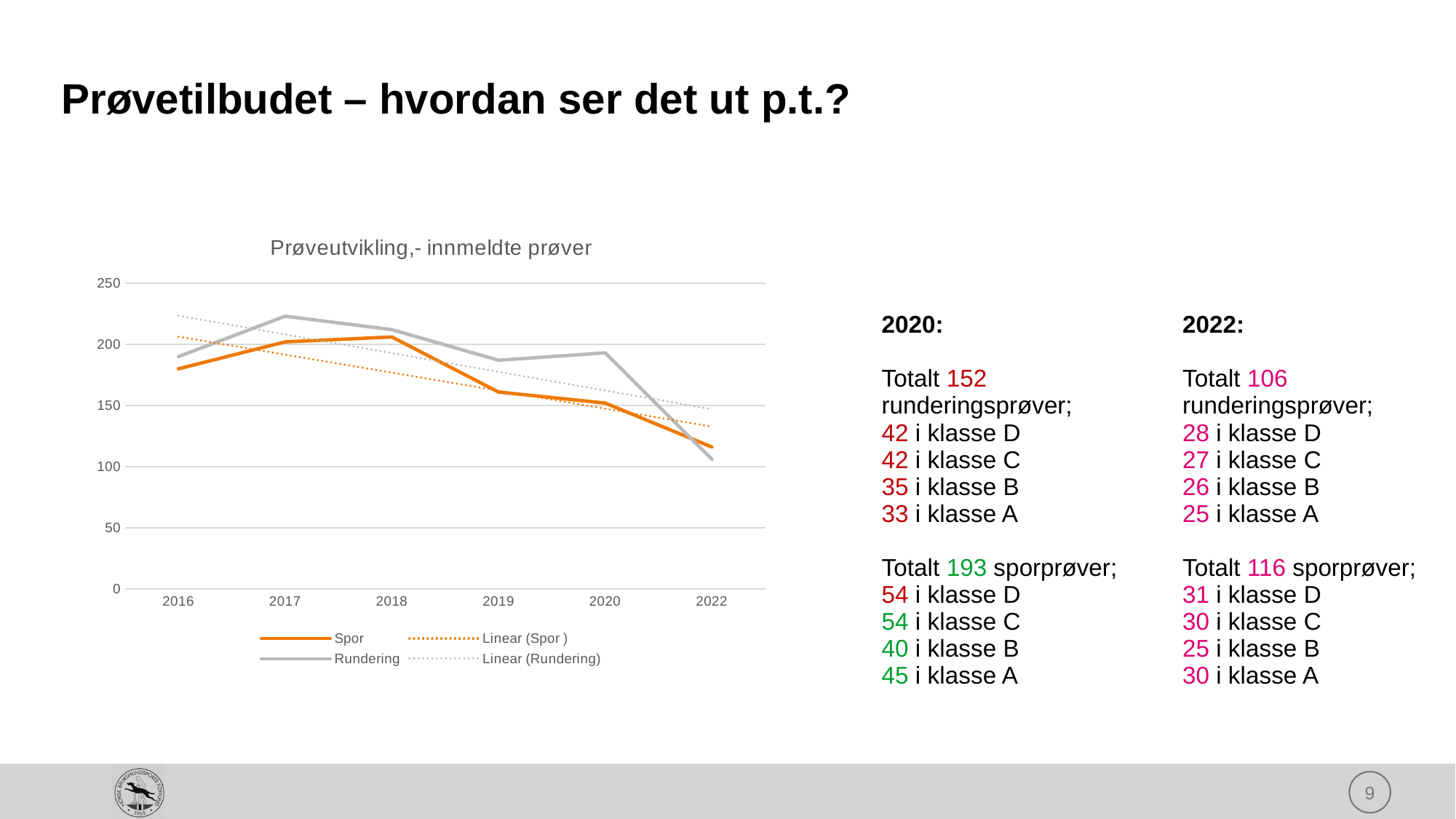
In which year is the Spor line at its lowest? 2022 How many entries does the chart legend list? 4 How many years are shown on the x axis of the chart? 6 Is the value for Spor in 2016 greater or less than 200? less Is the value for Rundering in 2017 greater or less than 200? greater In which year is the Rundering line at its lowest? 2022 Is the value for Rundering in 2020 greater or less than 150? greater In 2020, which series has the higher value, Spor or Rundering? Rundering What is the title of the chart? Prøveutvikling,- innmeldte prøver Does the Spor line rise or fall from 2018 to 2022? fall What kind of chart is shown on the slide? line chart